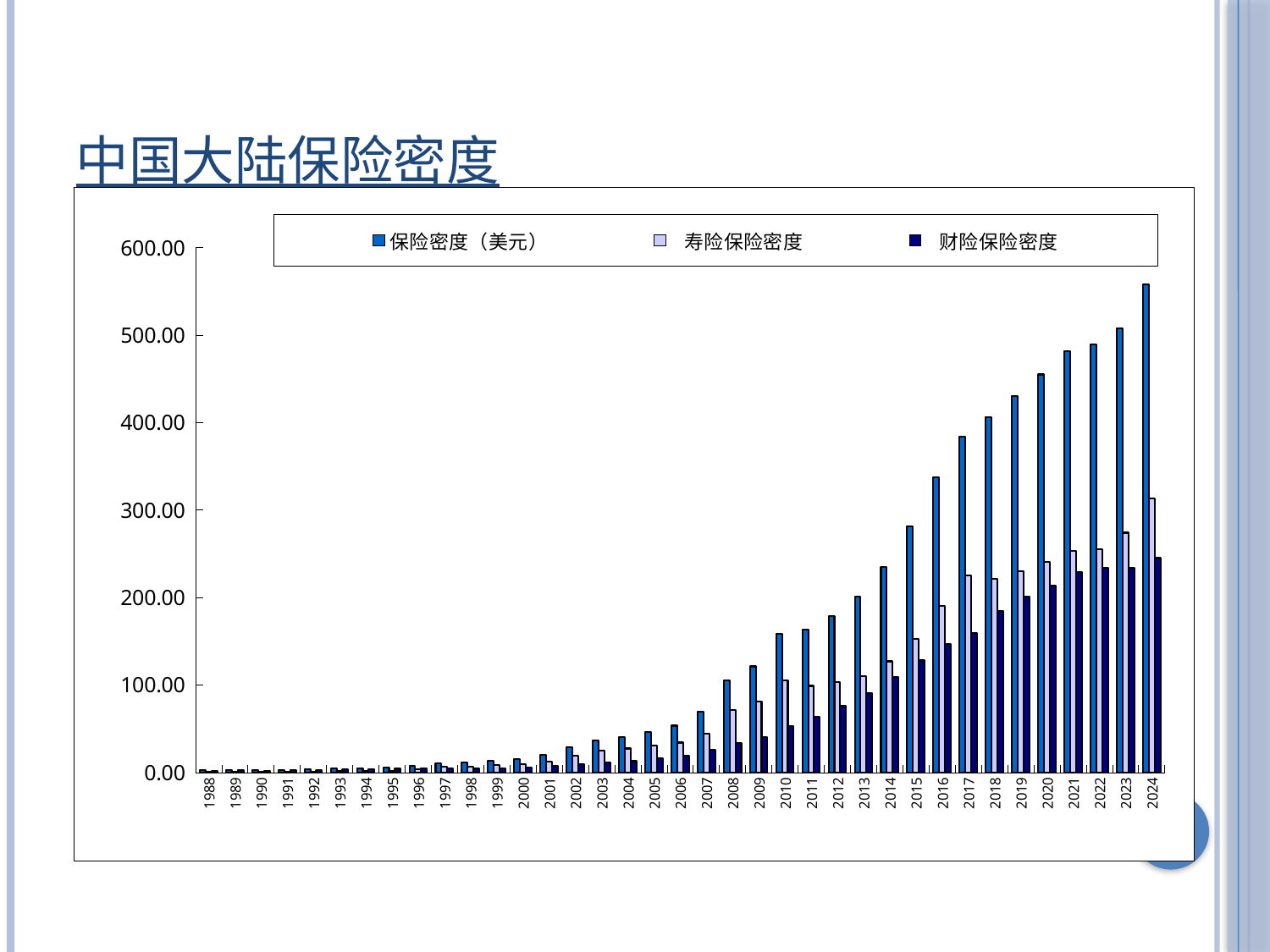
Which year has the highest value for 保险密度（美元）? 2024 Is the value for 保险密度（美元） in 2010 greater or less than 100.00? greater How many years are shown along the x axis? 37 Is the value for 财险保险密度 in 2024 greater or less than 300.00? less How many series does the legend list? 3 In 2024, which is larger: 寿险保险密度 or 财险保险密度? 寿险保险密度 What kind of chart is shown on the slide? bar chart What is the title of the slide? 中国大陆保险密度 Which is larger: 保险密度（美元） in 2020 or in 2019? 2020 Do the values for 保险密度（美元） generally rise or fall from 1988 to 2024? rise Is the value for 保险密度（美元） in 2017 greater or less than 400.00? less